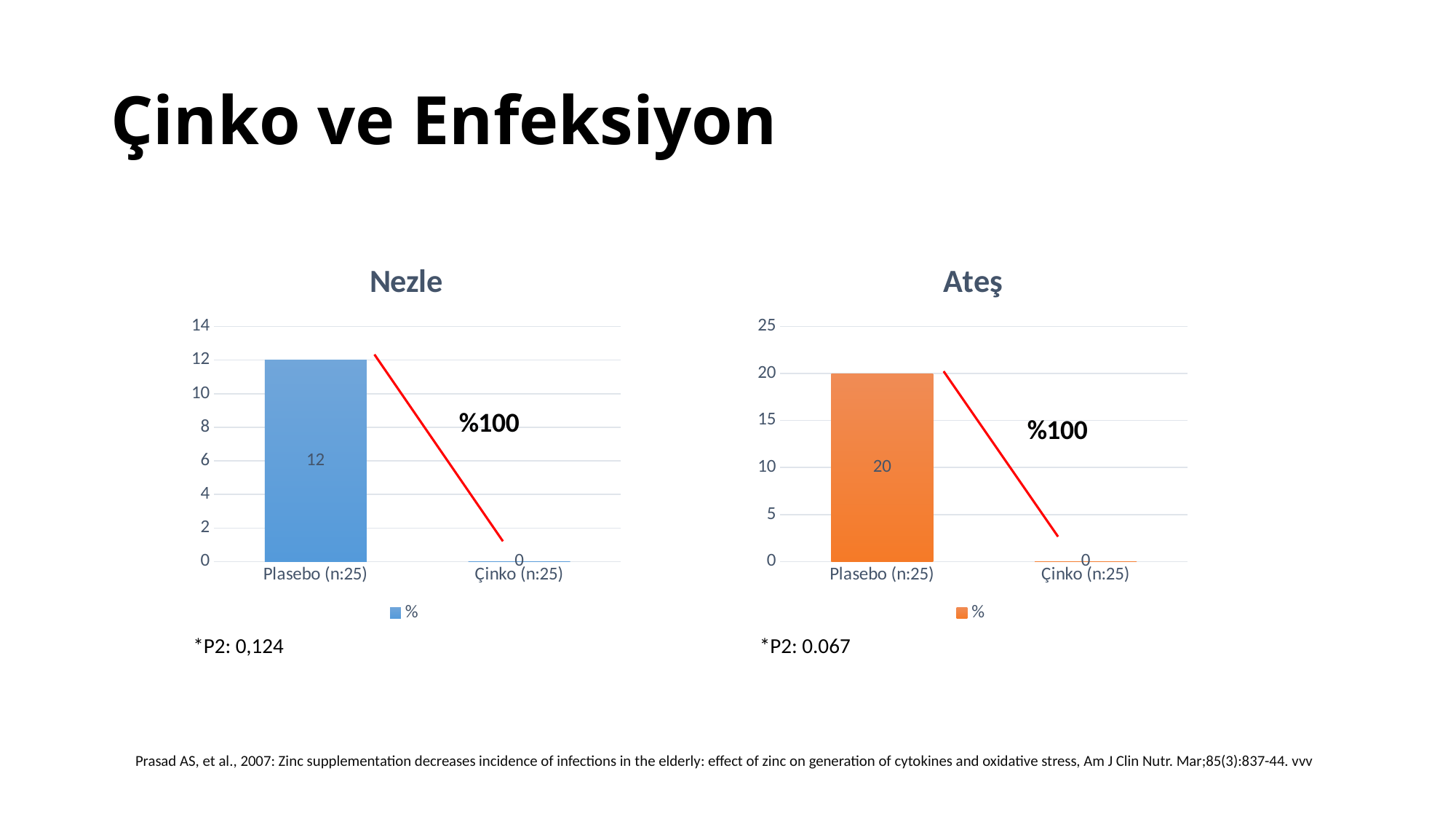
What is the title of the chart on the left? Nezle In the Ateş chart, which category has the lowest value? Çinko (n:25) What kind of chart is the Ateş chart? Bar chart Which is larger: the Plasebo (n:25) value in the Nezle chart or the Plasebo (n:25) value in the Ateş chart? Ateş In the Ateş chart, what is the difference between the Plasebo (n:25) and Çinko (n:25) values? 20 How many categories does the Nezle chart show? 2 In the Ateş chart, what is the value for Plasebo (n:25)? 20 In the Nezle chart, what is the value for Plasebo (n:25)? 12 In the Nezle chart, which category has the highest value? Plasebo (n:25) In the Nezle chart, what is the difference between the Plasebo (n:25) and Çinko (n:25) values? 12 In the Nezle chart, what is the value for Çinko (n:25)? 0 In the Ateş chart, what is the value for Çinko (n:25)? 0